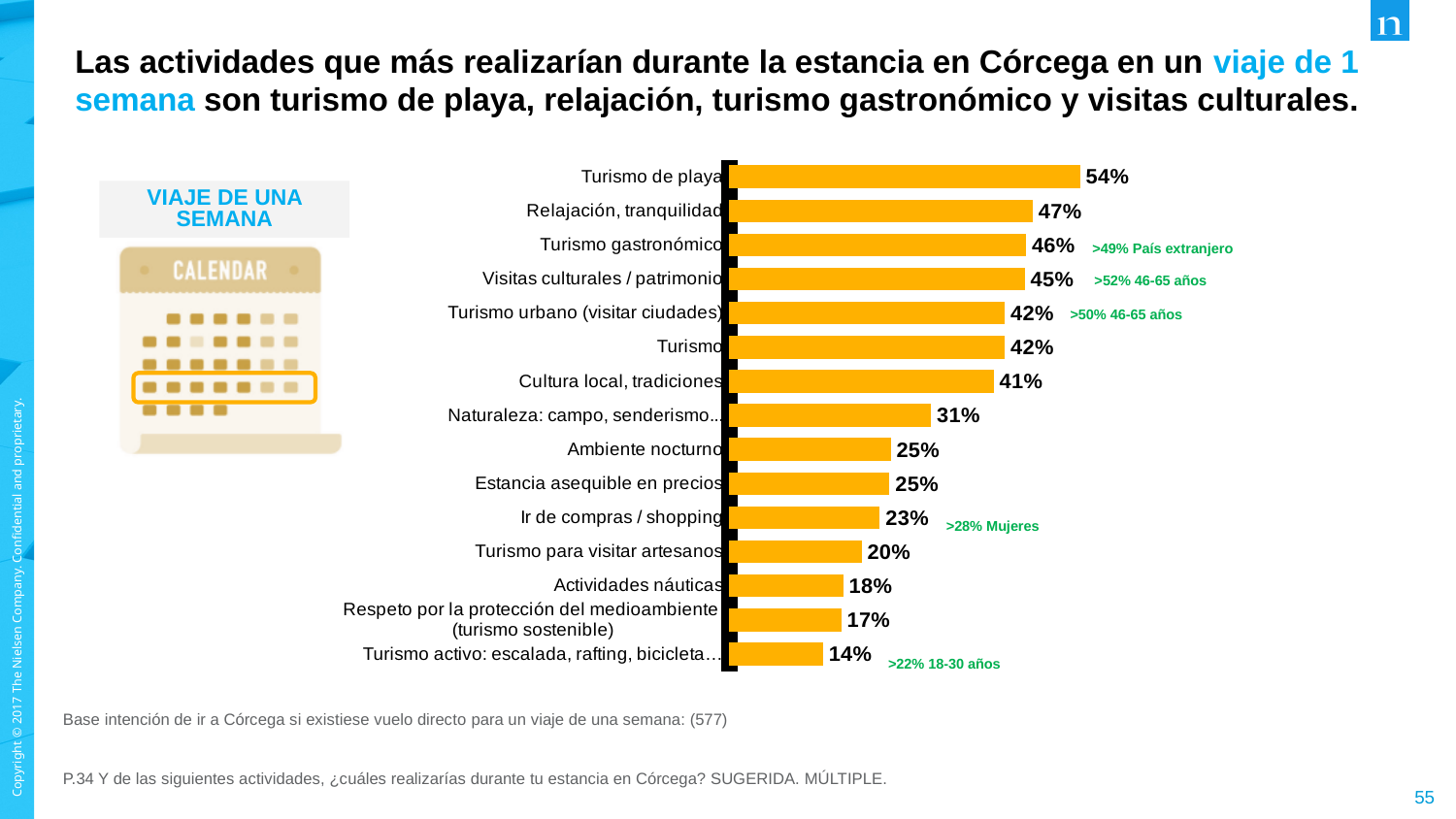
What is the difference between the values for Turismo de playa and Naturaleza: campo, senderismo...? 23% What colour are the bars in the chart? Orange What is the value for Turismo de playa? 54% What kind of chart is shown on the slide? Bar chart Which is larger, the value for Cultura local, tradiciones or the value for Ambiente nocturno? Cultura local, tradiciones What is the value for Actividades náuticas? 18% What is the value for Ir de compras / shopping? 23% Which category has the lowest value? Turismo activo: escalada, rafting, bicicleta… How many categories are shown in the chart? 15 Which category has the highest value? Turismo de playa What is the value for Relajación, tranquilidad? 47% What is the difference between the values for Turismo gastronómico and Visitas culturales / patrimonio? 1%